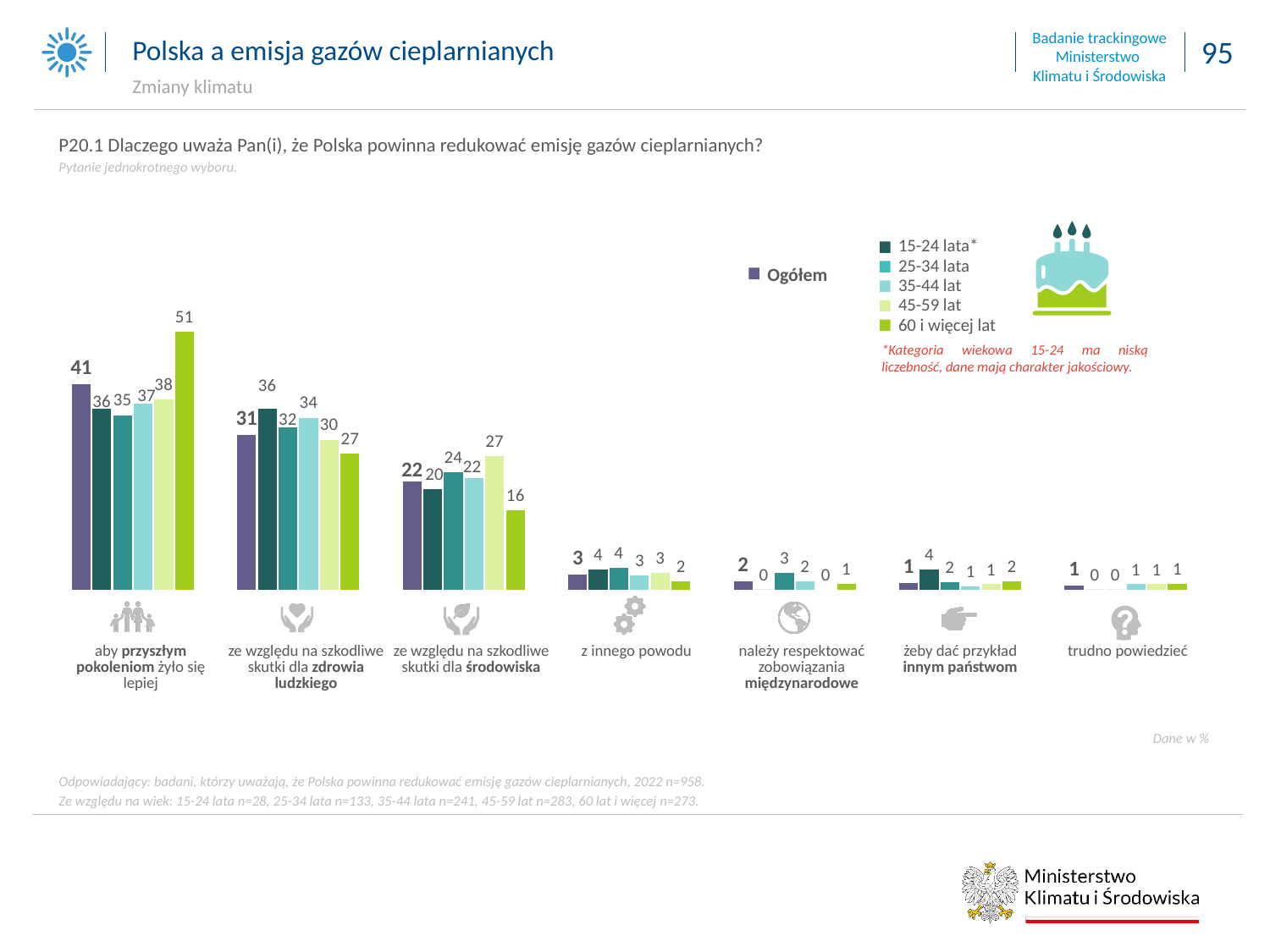
What is the value for the 15-24 lata group for "ze względu na szkodliwe skutki dla zdrowia ludzkiego"? 36 For "ze względu na szkodliwe skutki dla zdrowia ludzkiego", which is larger: the 15-24 lata value or the 60 i więcej lat value? 15-24 lata What is the value for the 60 i więcej lat group for "aby przyszłym pokoleniom żyło się lepiej"? 51 Which age group has the lowest value for "ze względu na szkodliwe skutki dla środowiska"? 60 i więcej lat What is the Ogółem (overall) value for "aby przyszłym pokoleniom żyło się lepiej"? 41 How many series does the legend list (including Ogółem)? 6 What type of chart is shown on the slide? bar chart What is the Ogółem value for "trudno powiedzieć"? 1 What is the value for the 45-59 lat group for "ze względu na szkodliwe skutki dla środowiska"? 27 Which reason has the highest Ogółem value? aby przyszłym pokoleniom żyło się lepiej What is the difference between the 60 i więcej lat value and the Ogółem value for "aby przyszłym pokoleniom żyło się lepiej"? 10 How many reason categories are shown on the x axis? 7